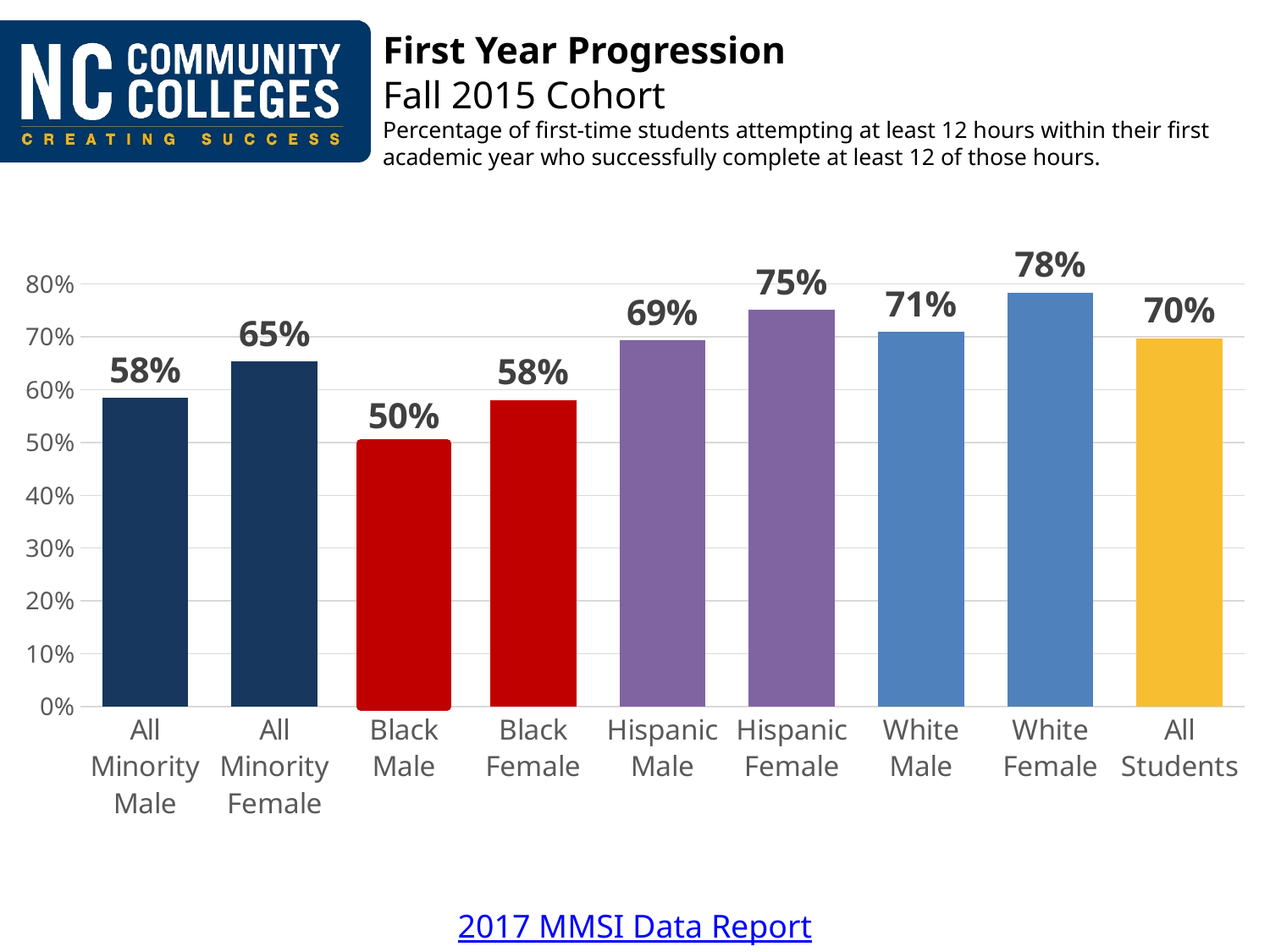
What is the difference between the values for White Female and Black Male? 28% How many categories are shown on the x axis? 9 What is the difference between the values for All Minority Female and All Minority Male? 7% What is the value for Black Male? 50% Which is larger, the value for Hispanic Male or the value for White Male? White Male Which category has the lowest value? Black Male Which category has the highest value? White Female What is the title of the chart? First Year Progression What kind of chart is shown on the slide? Bar chart What is the value for White Female? 78% What is the value for All Students? 70% What is the value for Hispanic Female? 75%